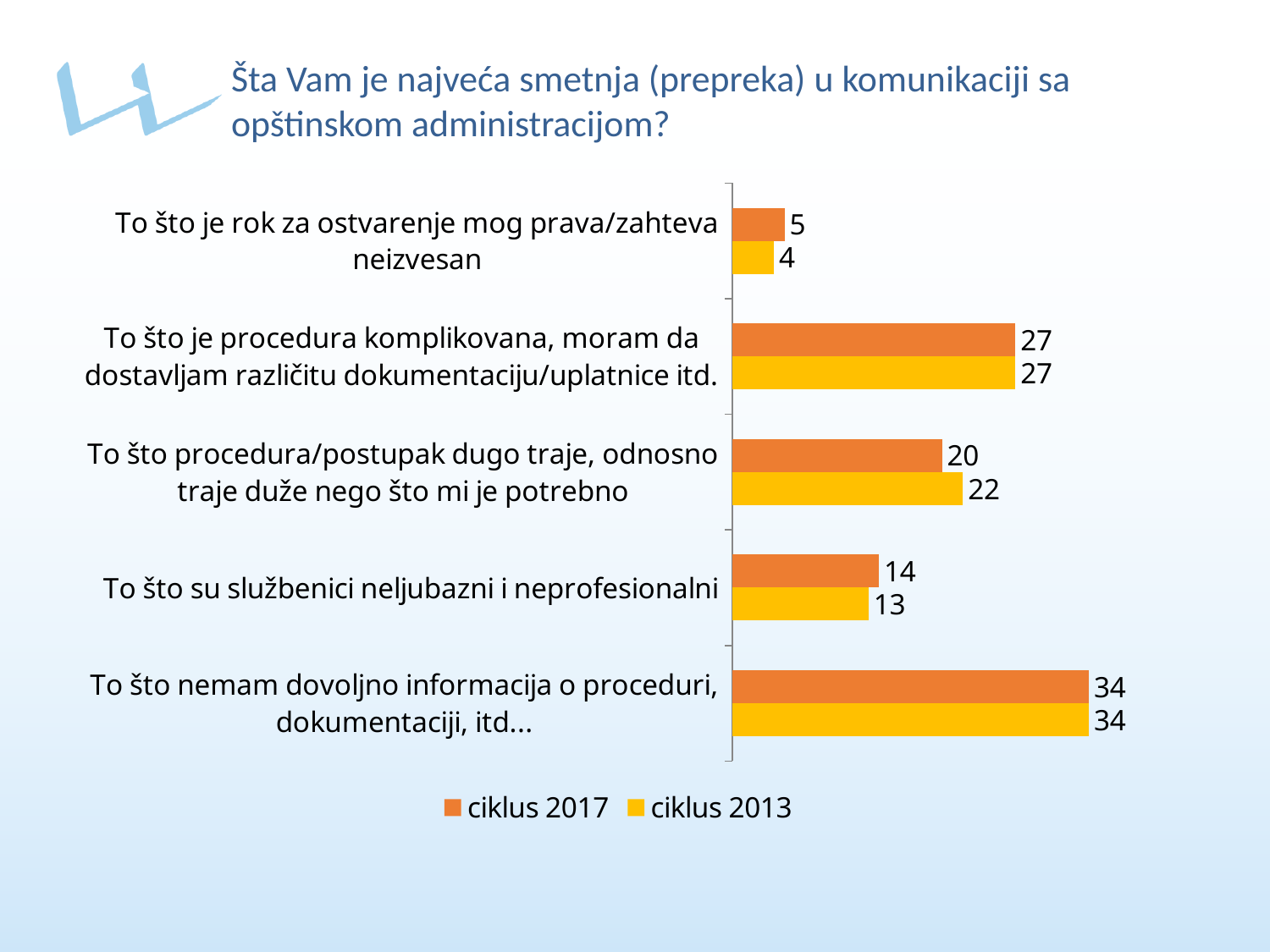
What kind of chart is shown on the slide? bar chart For 'To što su službenici neljubazni i neprofesionalni', which series has the larger value, 'ciklus 2017' or 'ciklus 2013'? ciklus 2017 Which category has the lowest value for 'ciklus 2013'? To što je rok za ostvarenje mog prava/zahteva neizvesan Which category has the highest value for 'ciklus 2017'? To što nemam dovoljno informacija o proceduri, dokumentaciji, itd... How many series does the legend list? 2 What is the value for 'ciklus 2017' for 'To što su službenici neljubazni i neprofesionalni'? 14 How many categories are shown on the chart? 5 What is the value for 'ciklus 2013' for 'To što procedura/postupak dugo traje, odnosno traje duže nego što mi je potrebno'? 22 Which colour represents 'ciklus 2013' in the chart? yellow What is the difference between the 'ciklus 2017' values for 'To što nemam dovoljno informacija o proceduri, dokumentaciji, itd...' and 'To što je procedura komplikovana, moram da dostavljam različitu dokumentaciju/uplatnice itd.'? 7 What is the value for 'ciklus 2013' for 'To što je rok za ostvarenje mog prava/zahteva neizvesan'? 4 What is the difference between the 'ciklus 2013' and 'ciklus 2017' values for 'To što procedura/postupak dugo traje, odnosno traje duže nego što mi je potrebno'? 2